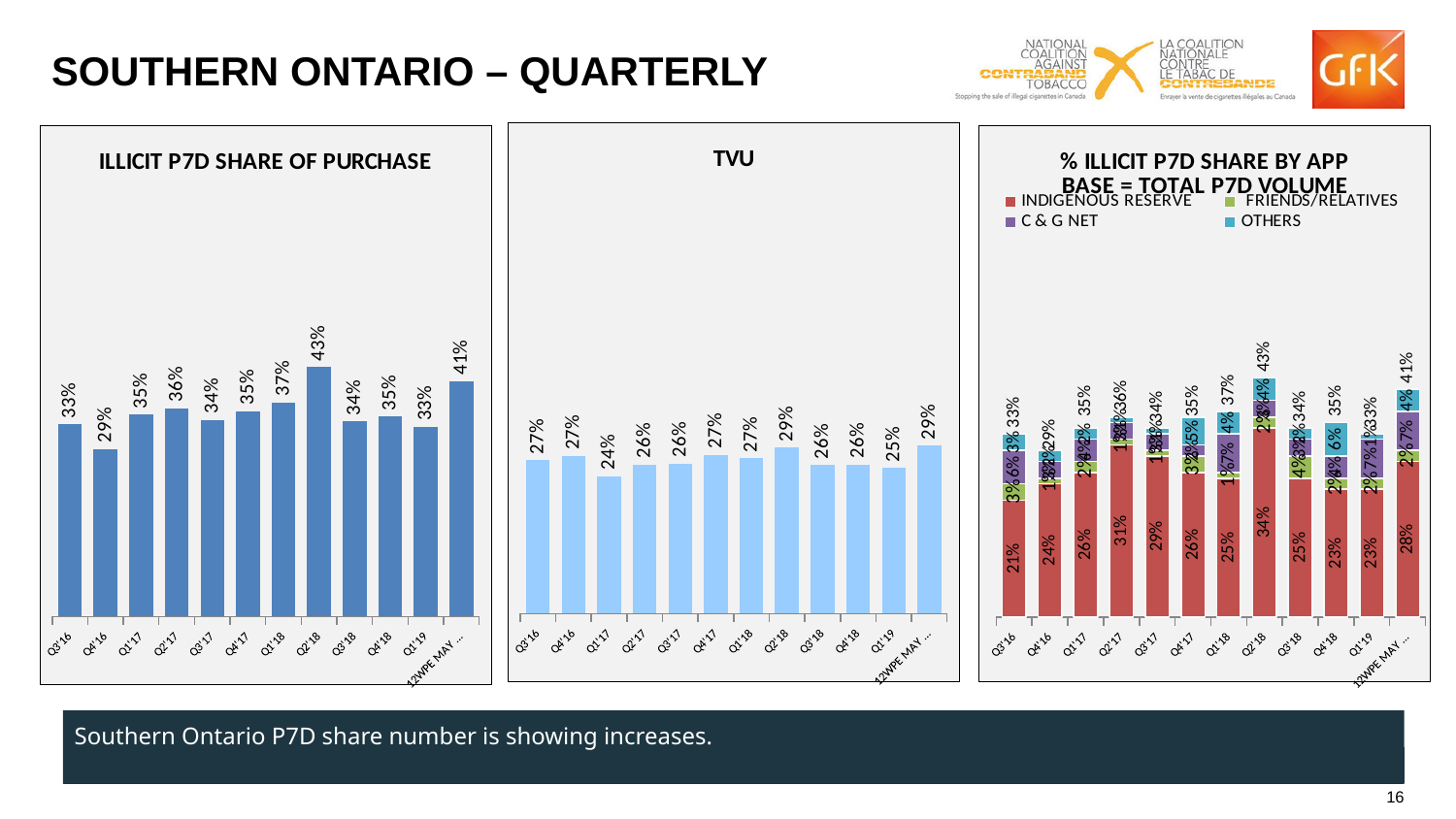
In the ILLICIT P7D SHARE OF PURCHASE chart, what is the value for Q2'18? 43% In the ILLICIT P7D SHARE OF PURCHASE chart, which quarter has the lowest value? Q4'16 In the ILLICIT P7D SHARE OF PURCHASE chart, what is the difference between the Q2'18 value and the Q4'16 value? 14 percentage points In the ILLICIT P7D SHARE OF PURCHASE chart, how many quarters/periods are plotted? 12 In the TVU chart, what is the value for Q1'17? 24% In the % ILLICIT P7D SHARE BY APP chart, what is the INDIGENOUS RESERVE value for Q2'18? 34% In the % ILLICIT P7D SHARE BY APP chart, which period has the lowest INDIGENOUS RESERVE value? Q3'16 In the % ILLICIT P7D SHARE BY APP chart, how many series does the legend list? 4 What kind of chart is the TVU chart? bar chart In the TVU chart, which period has the lowest value? Q1'17 In the TVU chart, is the value for Q2'18 larger or smaller than the value for Q3'18? larger In the % ILLICIT P7D SHARE BY APP chart, what is the total of the stacked bar for Q1'18? 37%